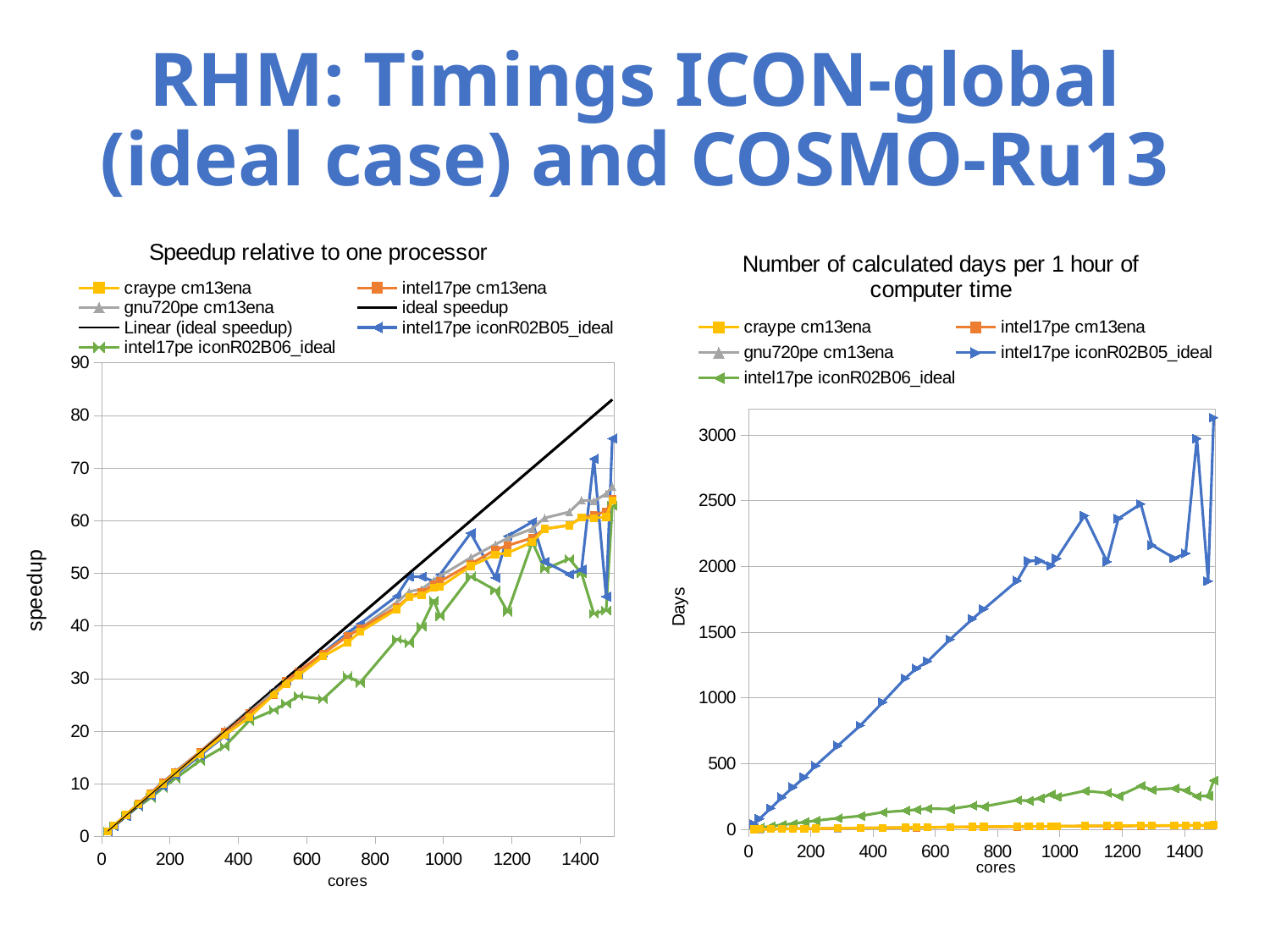
In the "Speedup relative to one processor" chart, is the ideal speedup at 1400 cores greater or less than 70? greater In the "Number of calculated days per 1 hour of computer time" chart, what is the label of the x axis? cores What kind of chart is the chart titled "Number of calculated days per 1 hour of computer time"? line chart In the "Speedup relative to one processor" chart, is the value for intel17pe iconR02B06_ideal at 800 cores greater or less than 40? less How many series does the legend of the "Number of calculated days per 1 hour of computer time" chart list? 5 How many series does the legend of the "Speedup relative to one processor" chart list? 7 What kind of chart is the chart titled "Speedup relative to one processor"? line chart In the "Number of calculated days per 1 hour of computer time" chart, is the value for intel17pe iconR02B06_ideal at 1400 cores greater or less than 500? less In the "Number of calculated days per 1 hour of computer time" chart, which series is higher at 1000 cores: intel17pe iconR02B05_ideal or intel17pe iconR02B06_ideal? intel17pe iconR02B05_ideal In the "Speedup relative to one processor" chart, what is the label of the y axis? speedup In the "Number of calculated days per 1 hour of computer time" chart, does the intel17pe iconR02B05_ideal series generally rise or fall as the number of cores increases? rise